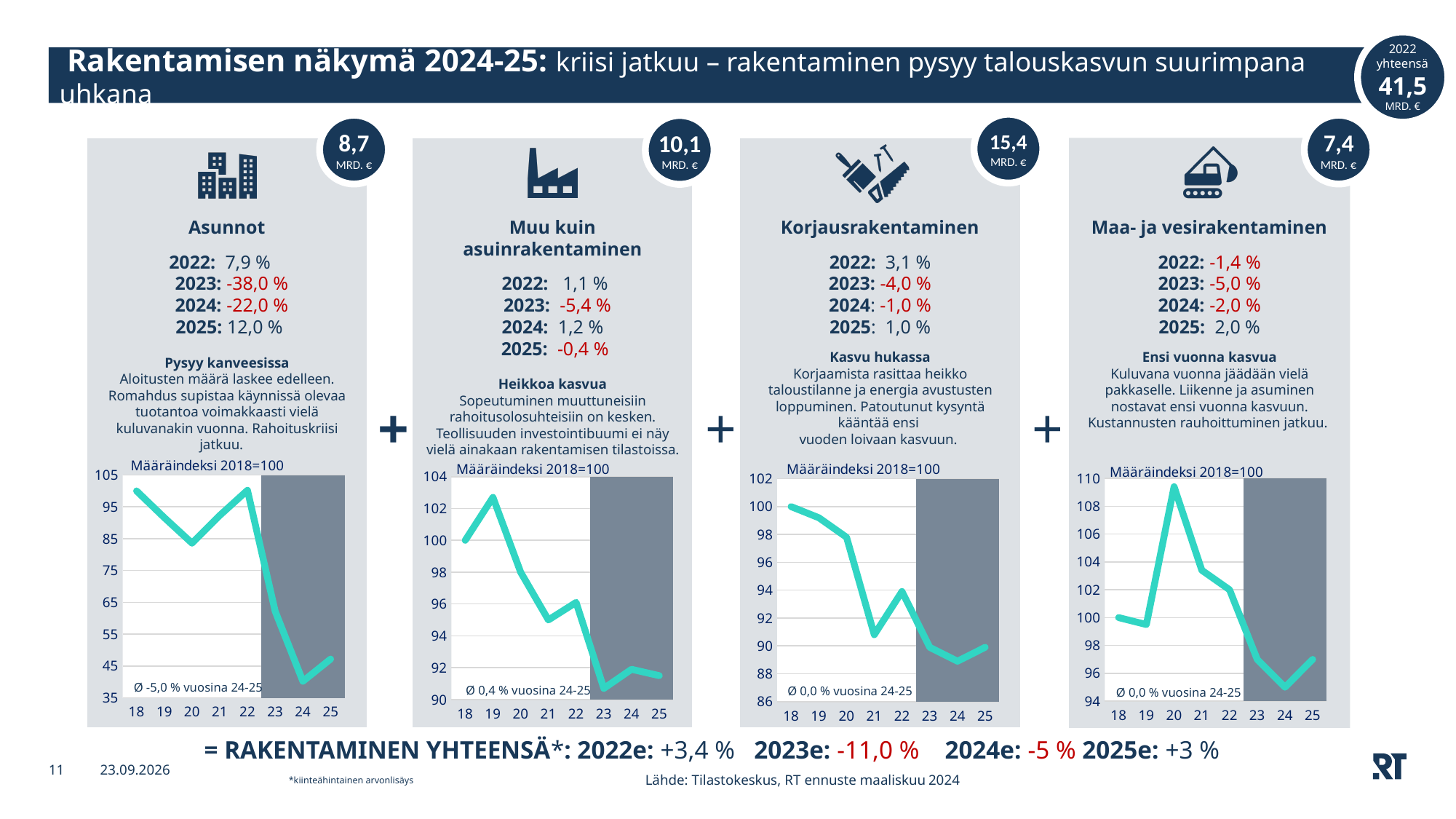
What kind of chart is shown in the Asunnot panel? line chart What average annual change for 2024-25 is printed on the Asunnot chart? Ø -5,0 % vuosina 24-25 In the Maa- ja vesirakentaminen chart, which year has the highest index value? 20 In the Muu kuin asuinrakentaminen chart, which year has the highest index value? 19 In the Maa- ja vesirakentaminen chart, is the value for 20 greater or less than 108? greater In the Muu kuin asuinrakentaminen chart, is the value for 23 greater or less than 92? less In the Asunnot chart, which year has the lowest index value? 24 In the Muu kuin asuinrakentaminen chart, what is the index value for 18? 100 In the Korjausrakentaminen chart, is the value for 21 greater or less than 92? less How many years are plotted on the x axis of the Maa- ja vesirakentaminen chart? 8 In the Korjausrakentaminen chart, which year has the lowest index value? 24